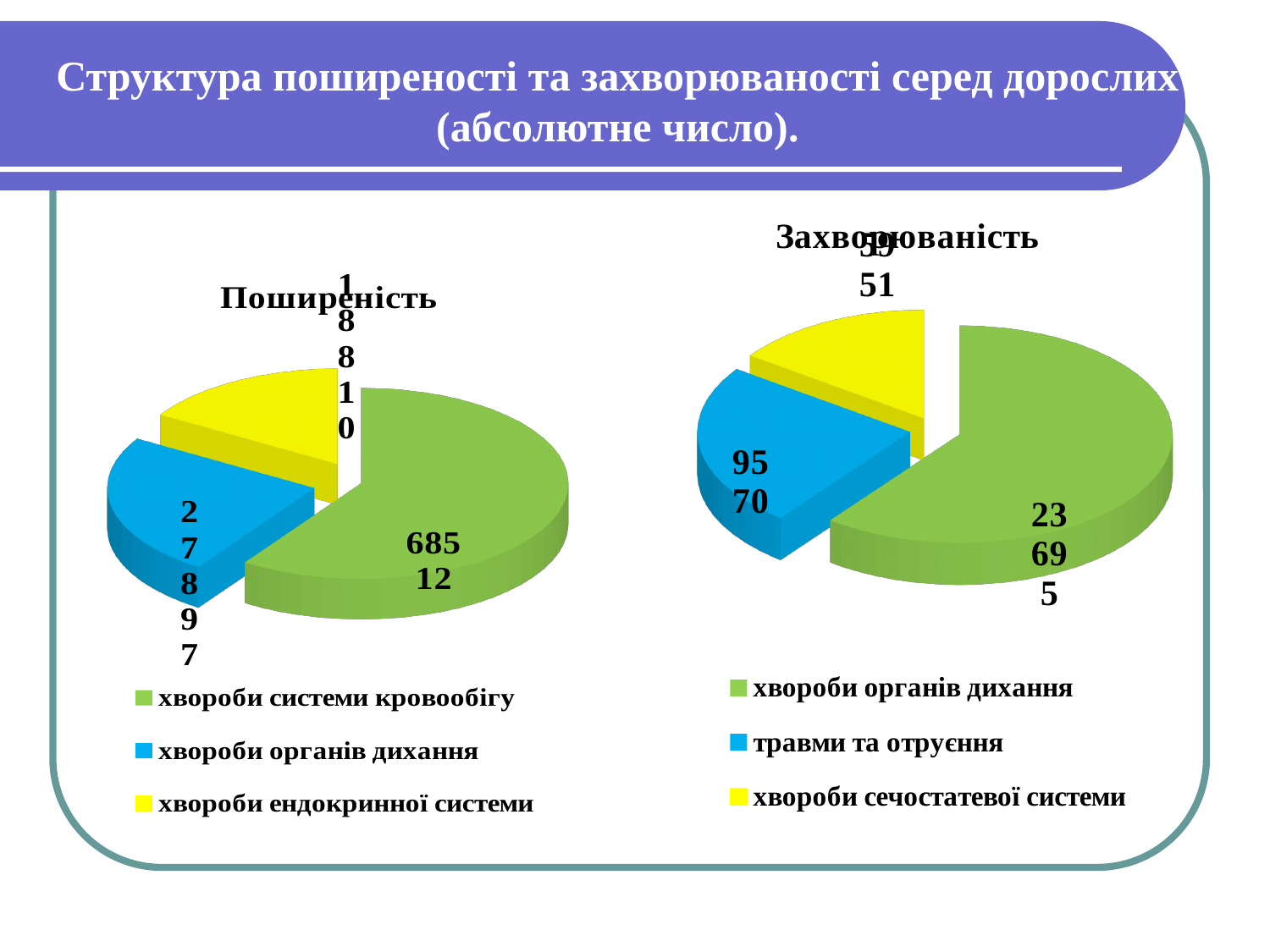
In the "Поширеність" chart, which category has the largest slice? хвороби системи кровообігу In the "Захворюваність" chart, which category has the largest slice? хвороби органів дихання In the "Поширеність" chart, which is larger: хвороби органів дихання or хвороби ендокринної системи? хвороби органів дихання In the "Поширеність" chart, which category has the smallest slice? хвороби ендокринної системи In the "Захворюваність" chart, what is the value for травми та отруєння? 9570 What kind of charts are shown on the slide? Pie charts In the "Захворюваність" chart, what is the value for хвороби органів дихання? 23695 In the "Захворюваність" chart, which category has the smallest slice? хвороби сечостатевої системи In the "Захворюваність" chart, what is the difference between хвороби органів дихання and травми та отруєння? 14125 How many categories does the legend of the "Захворюваність" chart list? 3 In the "Поширеність" chart, what is the value for хвороби органів дихання? 27897 In the "Поширеність" chart, what is the value for хвороби системи кровообігу? 68512